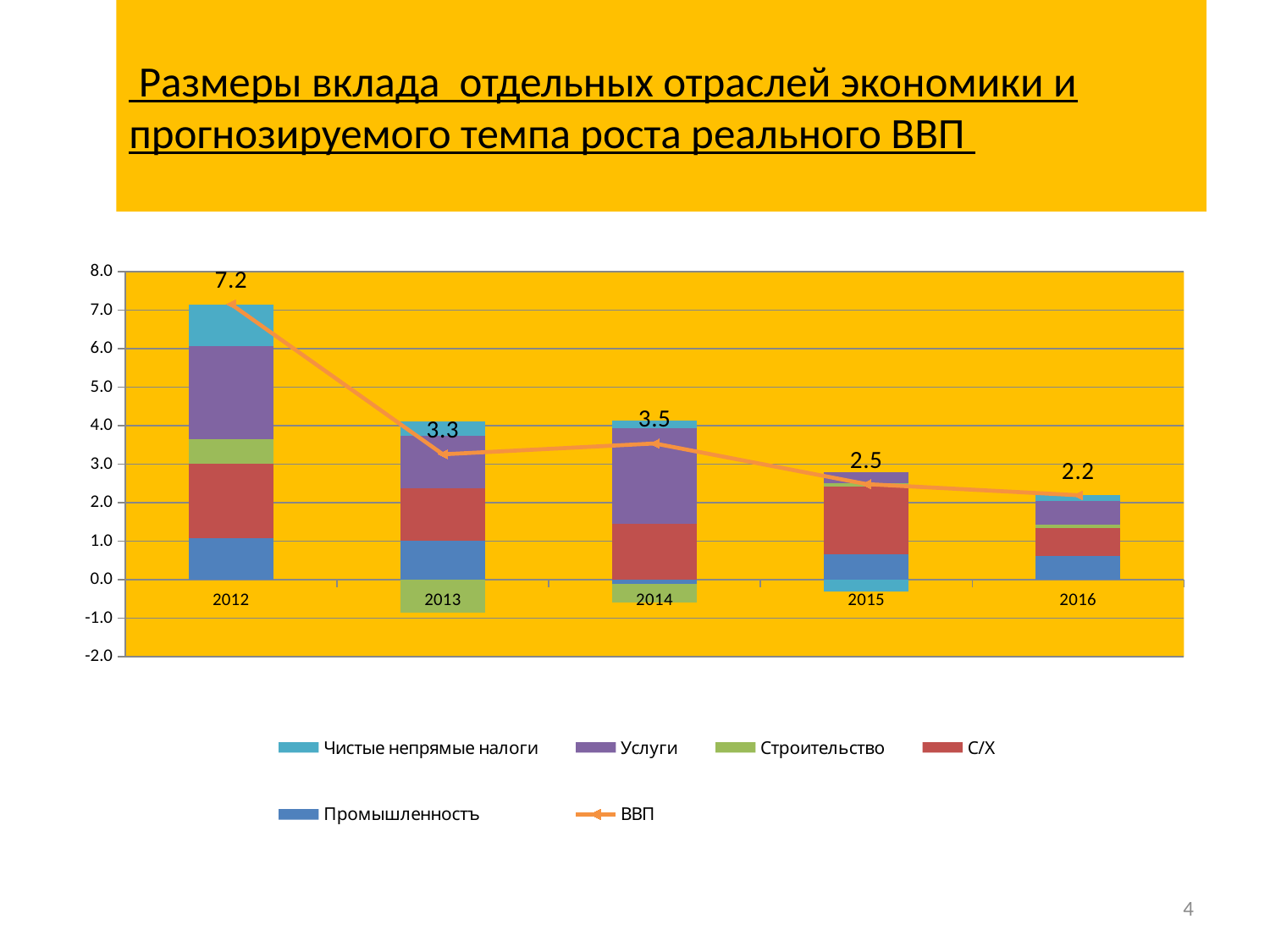
How many years are shown on the x axis? 5 What kind of chart is shown on the slide? Stacked bar chart with a line In which year is the ВВП value highest? 2012 Does the ВВП line rise or fall overall from 2012 to 2016? fall How many series does the legend list? 6 Which year has a larger ВВП value, 2013 or 2014? 2014 In which year is the ВВП value lowest? 2016 What is the ВВП value for 2014? 3.5 What is the ВВП value for 2012? 7.2 Is the top of the stacked bar for 2016 greater or less than 3.0? less What is the difference between the ВВП values for 2012 and 2013? 3.9 What is the ВВП value for 2016? 2.2